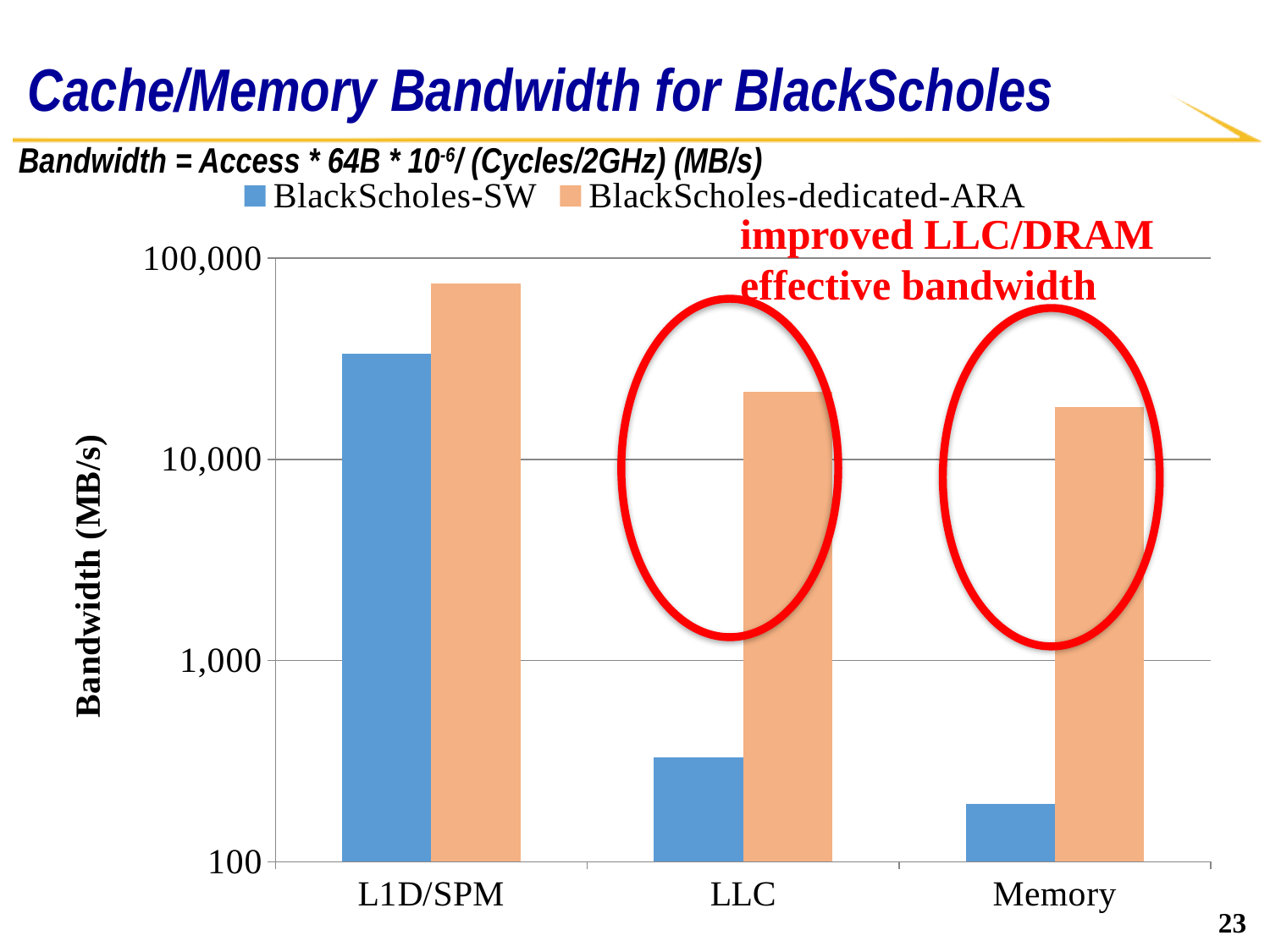
Which is larger for LLC: the BlackScholes-SW value or the BlackScholes-dedicated-ARA value? BlackScholes-dedicated-ARA Which category has the highest BlackScholes-dedicated-ARA bandwidth? L1D/SPM What is the label of the y axis? Bandwidth (MB/s) Which category has the lowest BlackScholes-SW bandwidth? Memory How many series does the legend list? 2 Is the BlackScholes-dedicated-ARA value for Memory greater or less than 10,000? greater What kind of chart is shown on the slide? bar chart Is the BlackScholes-SW value for L1D/SPM greater or less than 10,000? greater Do the BlackScholes-SW values rise or fall from L1D/SPM to Memory? fall How many categories are shown on the x axis? 3 Which category has the highest BlackScholes-SW bandwidth? L1D/SPM Is the BlackScholes-SW value for LLC greater or less than 1,000? less